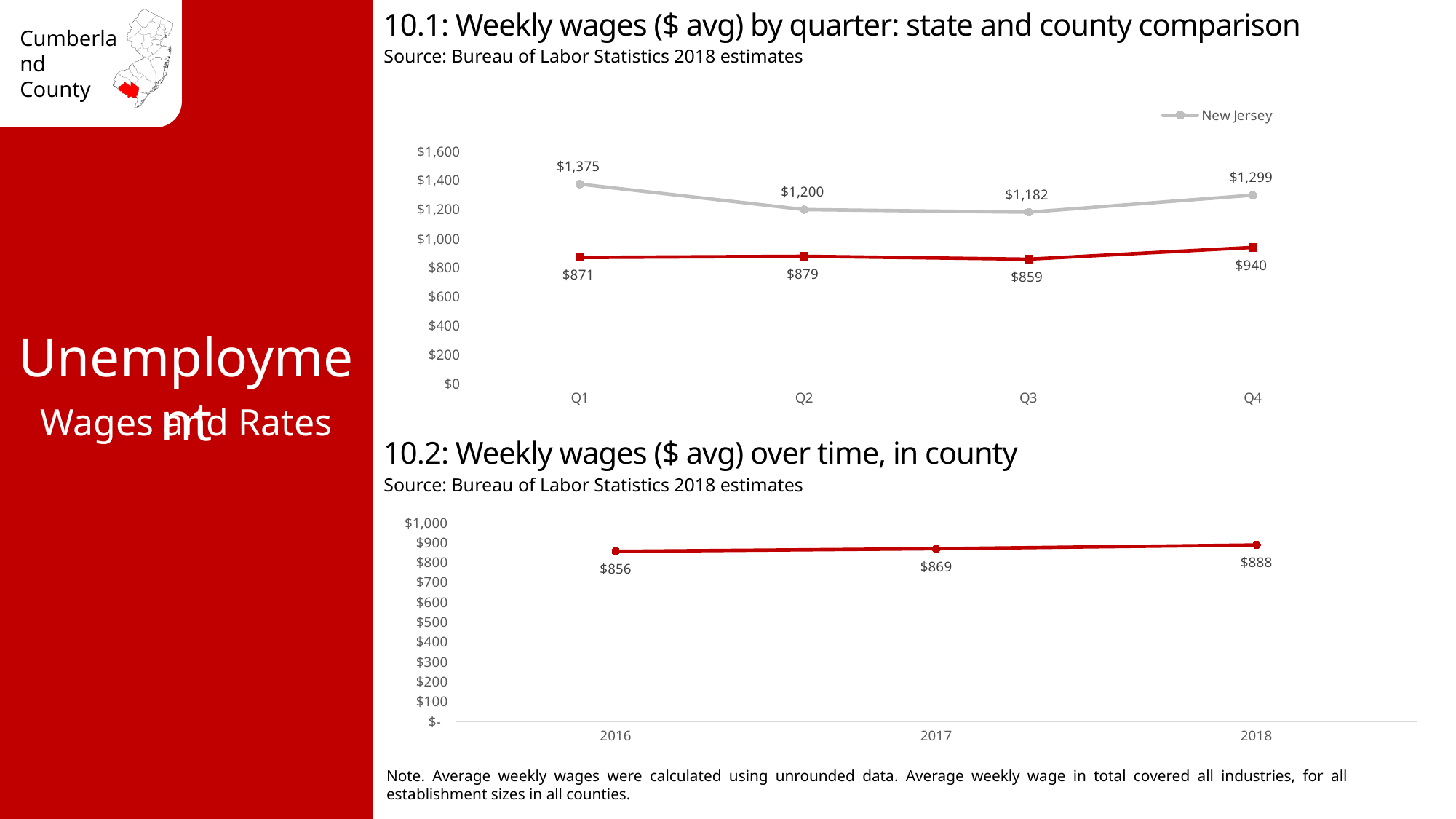
In the chart '10.2: Weekly wages ($ avg) over time, in county', do the values rise or fall from 2016 to 2018? Rise In the chart '10.1: Weekly wages ($ avg) by quarter: state and county comparison', how many quarters are shown on the x axis? 4 In the chart '10.1: Weekly wages ($ avg) by quarter: state and county comparison', in which quarter is the New Jersey value lowest? Q3 In the chart '10.1: Weekly wages ($ avg) by quarter: state and county comparison', what is the New Jersey value for Q1? $1,375 In the chart '10.1: Weekly wages ($ avg) by quarter: state and county comparison', is the New Jersey value in Q2 greater or less than $1,000? greater In the chart '10.1: Weekly wages ($ avg) by quarter: state and county comparison', which series name is shown in the legend? New Jersey What kind of chart is '10.2: Weekly wages ($ avg) over time, in county'? Line chart In the chart '10.2: Weekly wages ($ avg) over time, in county', what is the value for 2017? $869 In the chart '10.1: Weekly wages ($ avg) by quarter: state and county comparison', what is the value of the red series in Q4? $940 In the chart '10.1: Weekly wages ($ avg) by quarter: state and county comparison', what is the difference between the New Jersey value and the red series value in Q1? $504 In the chart '10.2: Weekly wages ($ avg) over time, in county', what is the difference between the 2018 and 2016 values? $32 In the chart '10.1: Weekly wages ($ avg) by quarter: state and county comparison', in which quarter is the red series highest? Q4